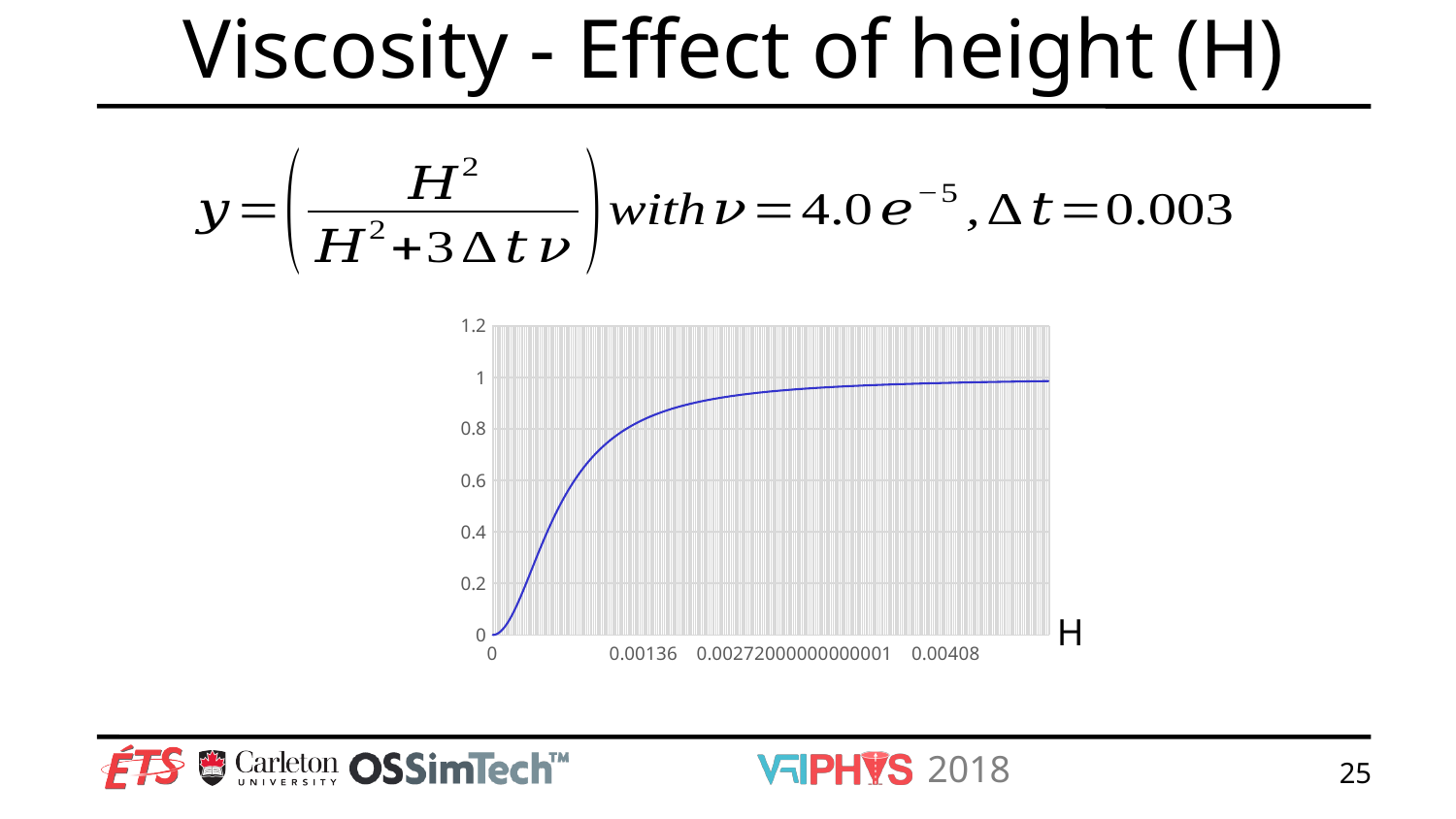
Which of the labelled x-axis ticks, 0.00136 or 0.00408, has the larger plotted value? 0.00408 What kind of chart is shown on the slide? line chart What is the label on the x axis of the chart? H What is the plotted value at H = 0? 0 At which labelled x-axis tick is the plotted value lowest? 0 Is the plotted value at H = 0.00136 greater or less than 0.6? greater Does the plotted value rise or fall as H increases along the x axis? rise Is the plotted value at H = 0.00408 greater or less than 1.2? less Is the plotted value at H = 0.00408 greater or less than 0.8? greater What is the highest tick value shown on the y axis? 1.2